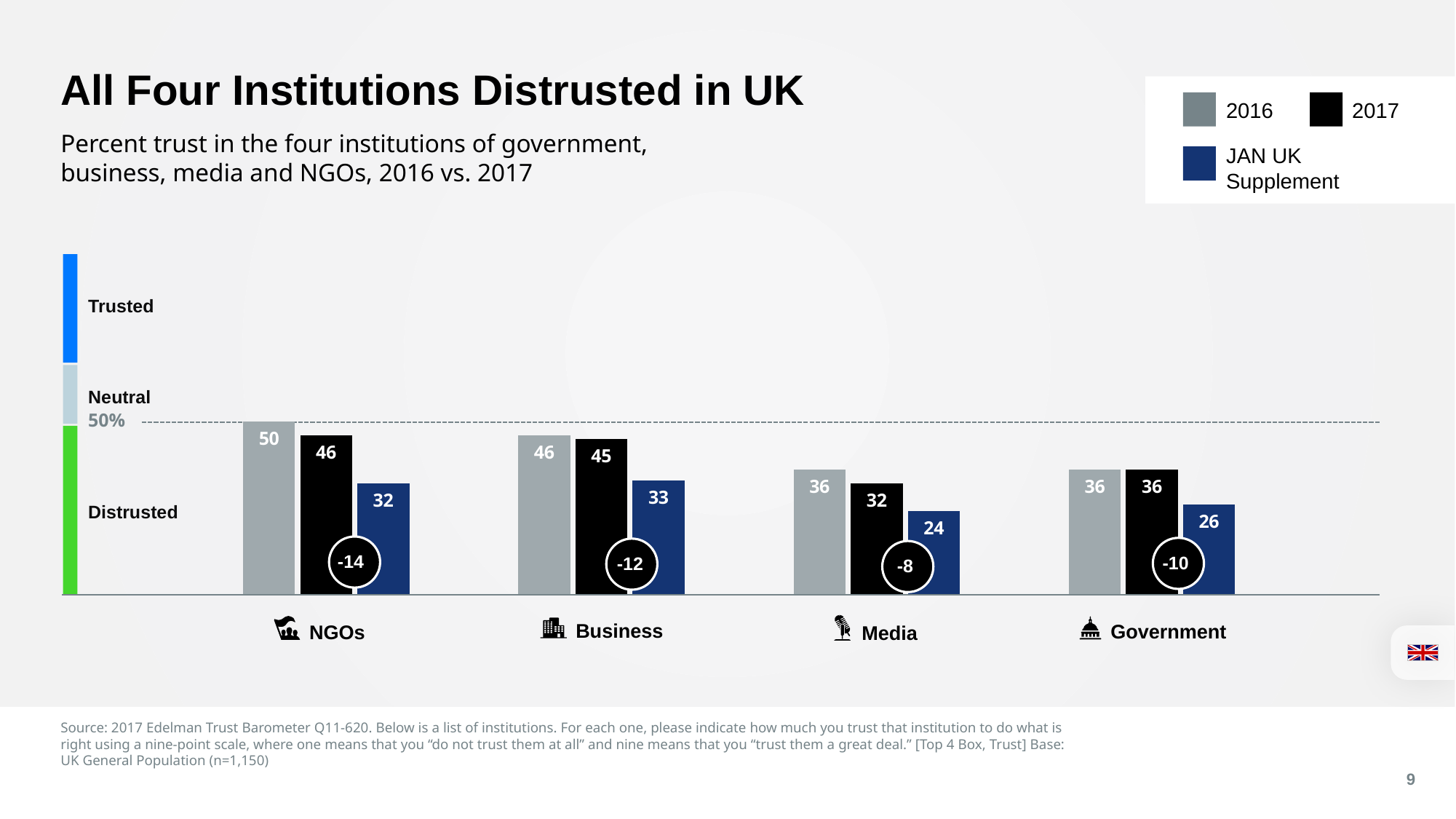
How many institutions are shown on the x axis? 4 Which institution has the highest 2016 value? NGOs Which is larger, the 2017 value for Business or the 2017 value for Media? 2017 value for Business What is the 2017 value for Government? 36 What kind of chart is shown on the slide? bar chart What is the 2016 value for NGOs? 50 How many series does the legend list? 3 What is the JAN UK Supplement value for Media? 24 Which institution has the lowest JAN UK Supplement value? Media What is the difference between the 2016 and 2017 values for NGOs? 4 What is the 2017 value for Business? 45